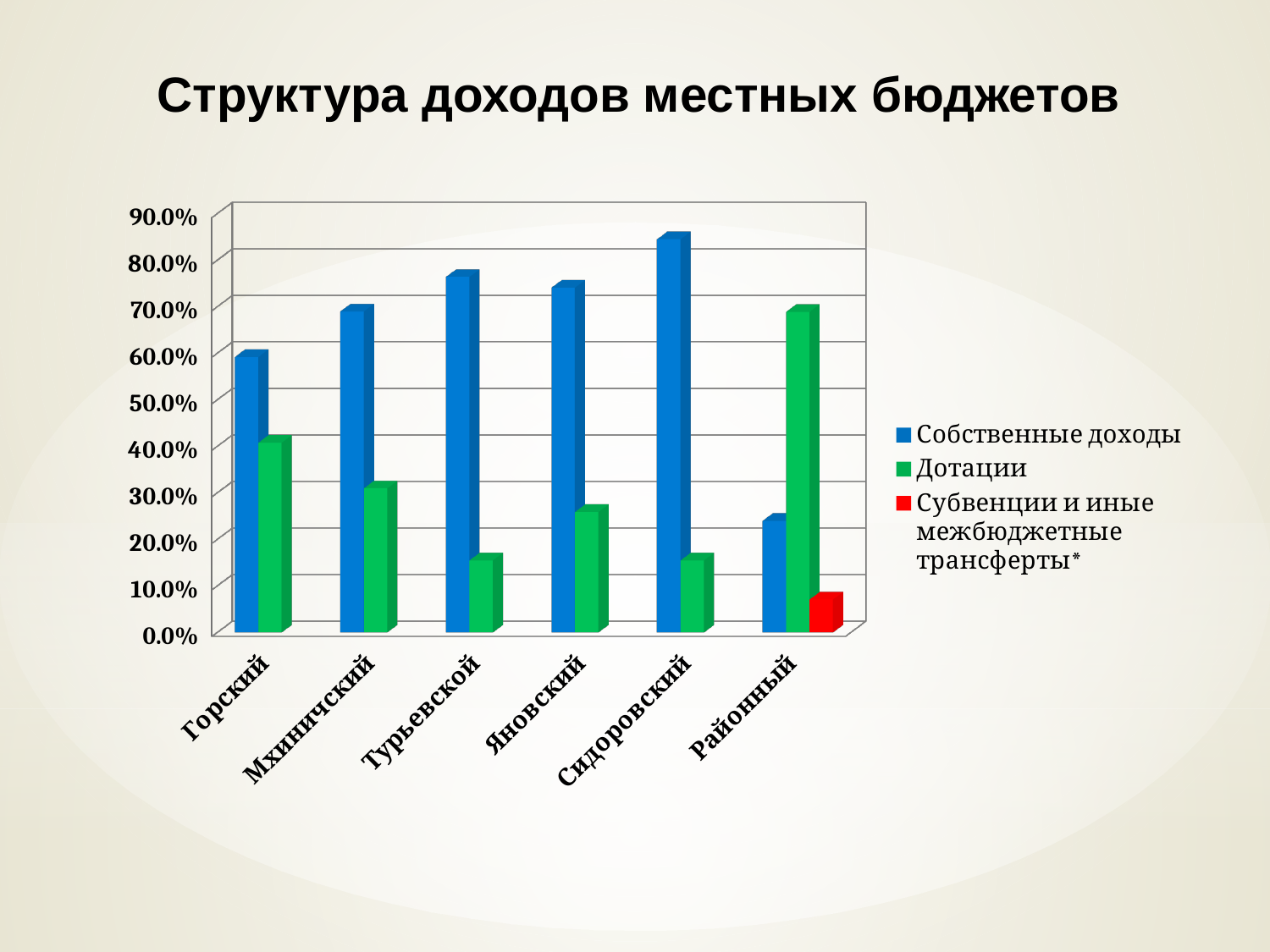
For Горский, which is larger: Собственные доходы or Дотации? Собственные доходы Which category has the highest value for Собственные доходы? Сидоровский What kind of chart is shown on the slide? bar chart Which category has the lowest value for Собственные доходы? Районный How many series does the legend list? 3 Which category has the highest value for Дотации? Районный Is the value for Собственные доходы in Районный greater or less than 30.0%? less Is the value for Дотации in Турьевской greater or less than 20.0%? less For Районный, which is larger: Собственные доходы or Дотации? Дотации Is the value for Собственные доходы in Сидоровский greater or less than 80.0%? greater What is the title of the chart on the slide? Структура доходов местных бюджетов How many categories are shown on the x axis of the chart? 6